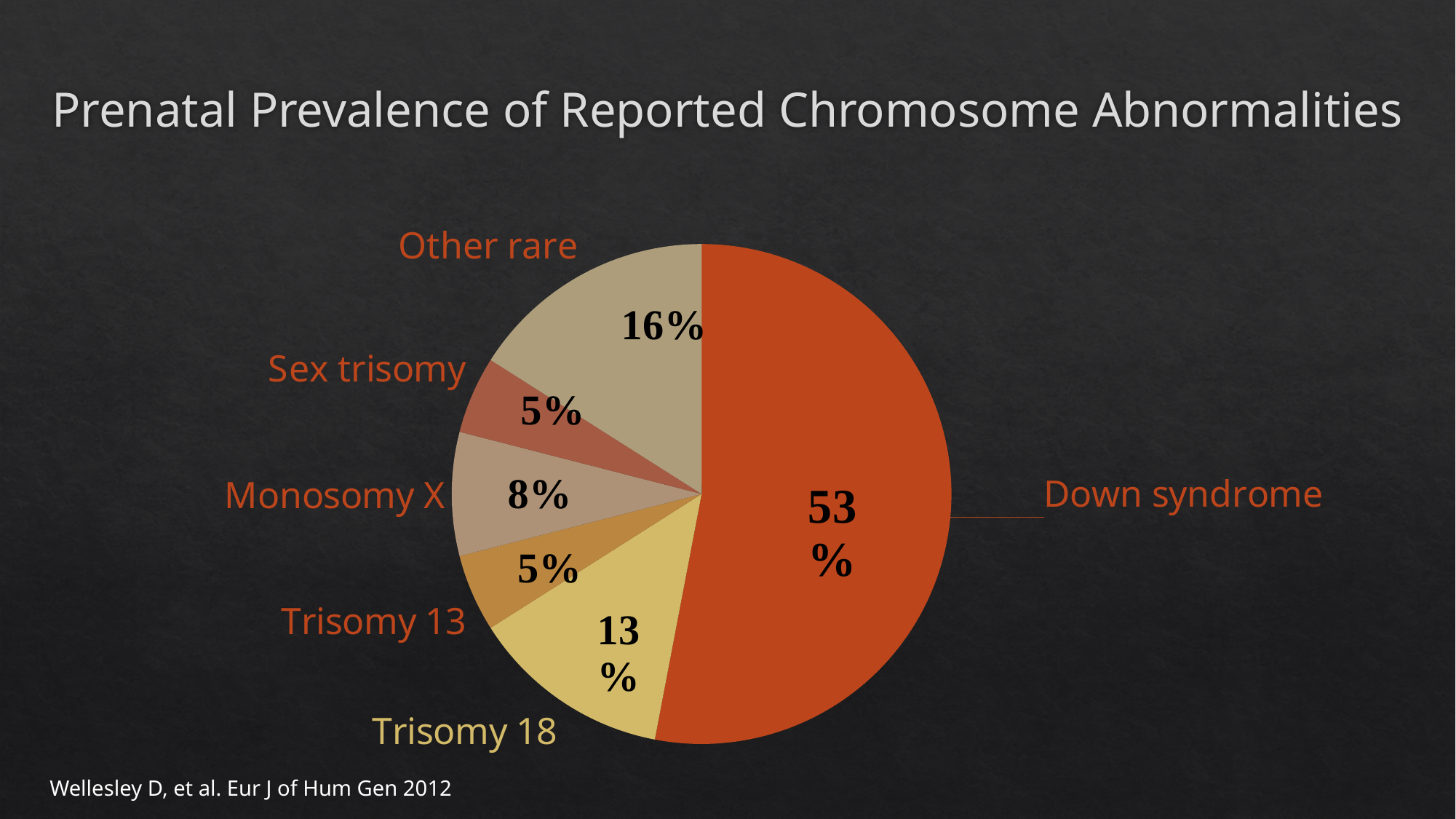
How many categories are shown in the pie chart? 6 What is the difference in percentage points between Trisomy 18 and Monosomy X? 5 What percentage is shown for Trisomy 18? 13% Which category has the largest slice of the pie? Down syndrome What kind of chart is shown on the slide? Pie chart What is the title of the chart? Prenatal Prevalence of Reported Chromosome Abnormalities What share of the pie does Down syndrome account for? 53% What percentage is shown for Other rare? 16% Which is larger, the share for Other rare or the share for Trisomy 18? Other rare What percentage is shown for Trisomy 13? 5% What is the difference in percentage points between Down syndrome and Other rare? 37 What percentage is shown for Monosomy X? 8%